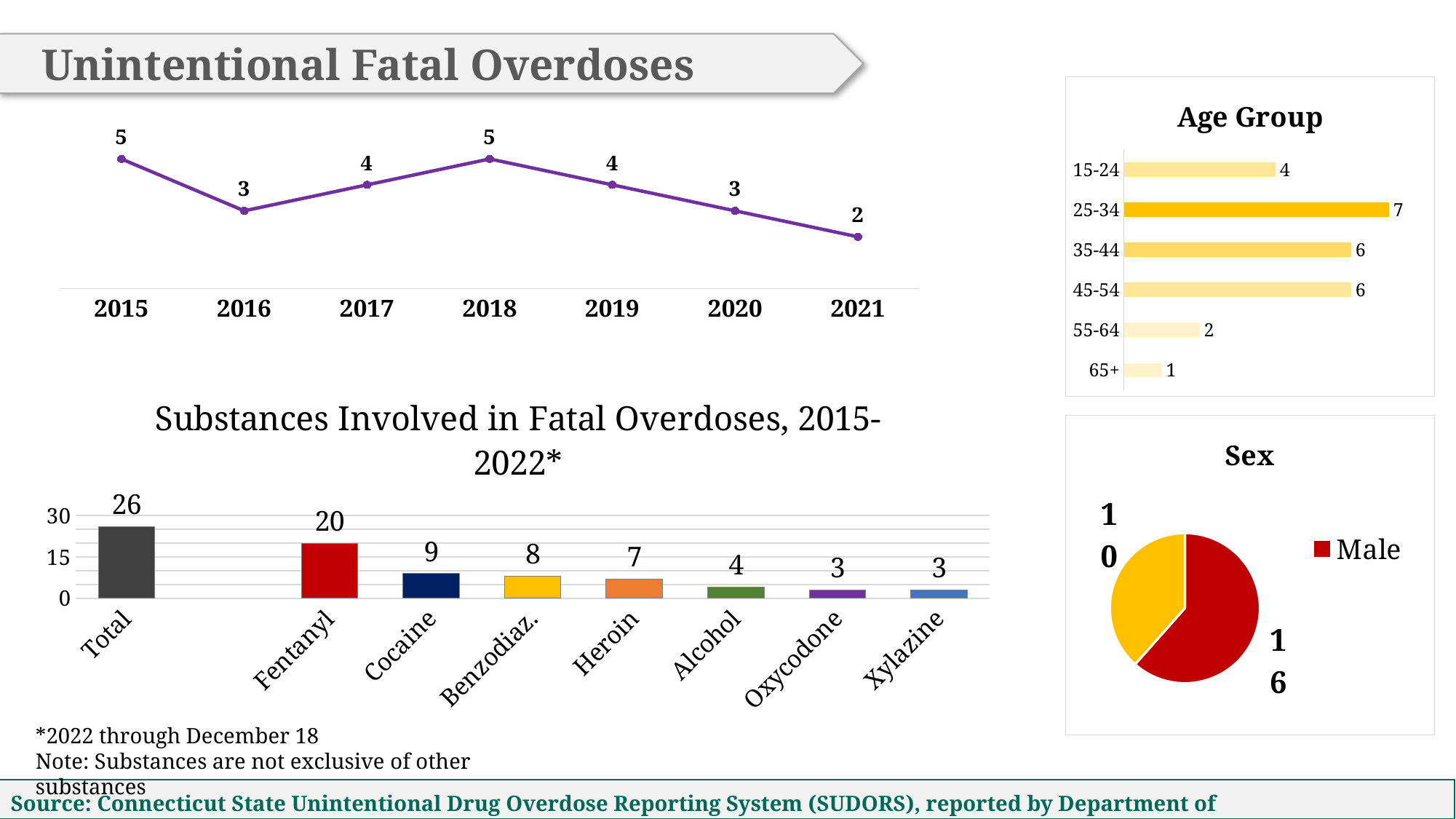
In the 'Age Group' chart, what is the value for 55-64? 2 In the 'Age Group' chart, which age group has the highest value? 25-34 In the 'Substances Involved in Fatal Overdoses, 2015-2022*' chart, what is the difference between Cocaine and Heroin? 2 In the 'Substances Involved in Fatal Overdoses, 2015-2022*' chart, which is larger, Benzodiaz. or Alcohol? Benzodiaz. In the line chart at the top left, what is the value for 2018? 5 In the line chart at the top left, what is the difference between the values for 2015 and 2021? 3 In the 'Age Group' chart, how many age groups are shown? 6 In the 'Substances Involved in Fatal Overdoses, 2015-2022*' chart, what is the value for Fentanyl? 20 In the line chart at the top left, which year has the lowest value? 2021 What kind of chart is the 'Substances Involved in Fatal Overdoses, 2015-2022*' chart? Bar chart In the 'Sex' pie chart, what is the value of the Male slice? 16 In the line chart at the top left, how many years are plotted? 7